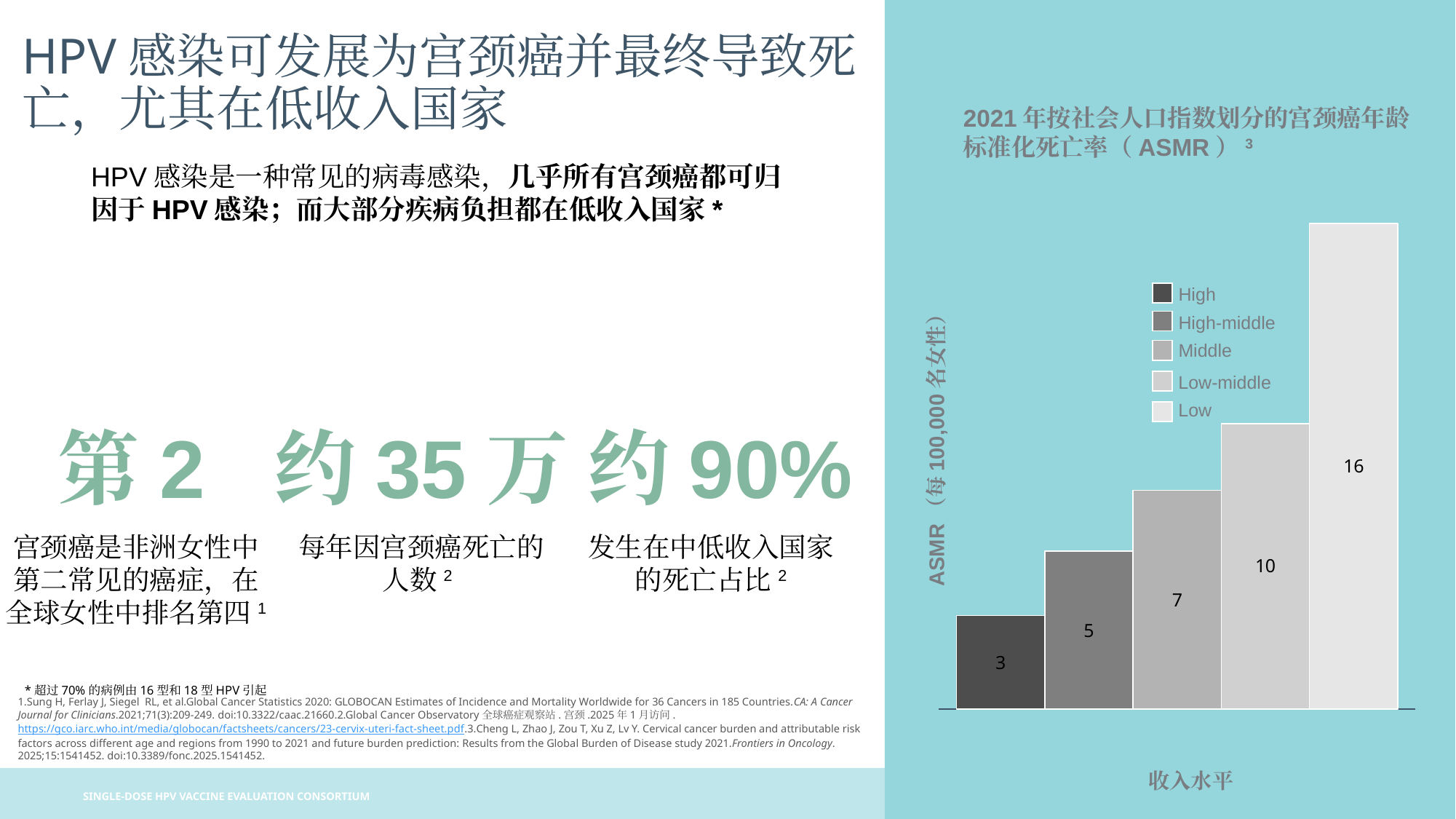
Which income level has the lowest ASMR? High What is the ASMR value for the Low income level? 16 What type of chart is shown on the slide? Bar chart What is the difference in ASMR between the Low and High income levels? 13 Which has a higher ASMR, Middle or High-middle? Middle Which income level has the highest ASMR? Low What is the ASMR value for the Low-middle income level? 10 What is the difference in ASMR between the Low-middle and High-middle income levels? 5 What is the ASMR value for the Middle income level? 7 How many income levels are shown in the chart? 5 What is the ASMR value for the High income level? 3 Do the ASMR values rise or fall moving from High to Low income level along the x axis? Rise